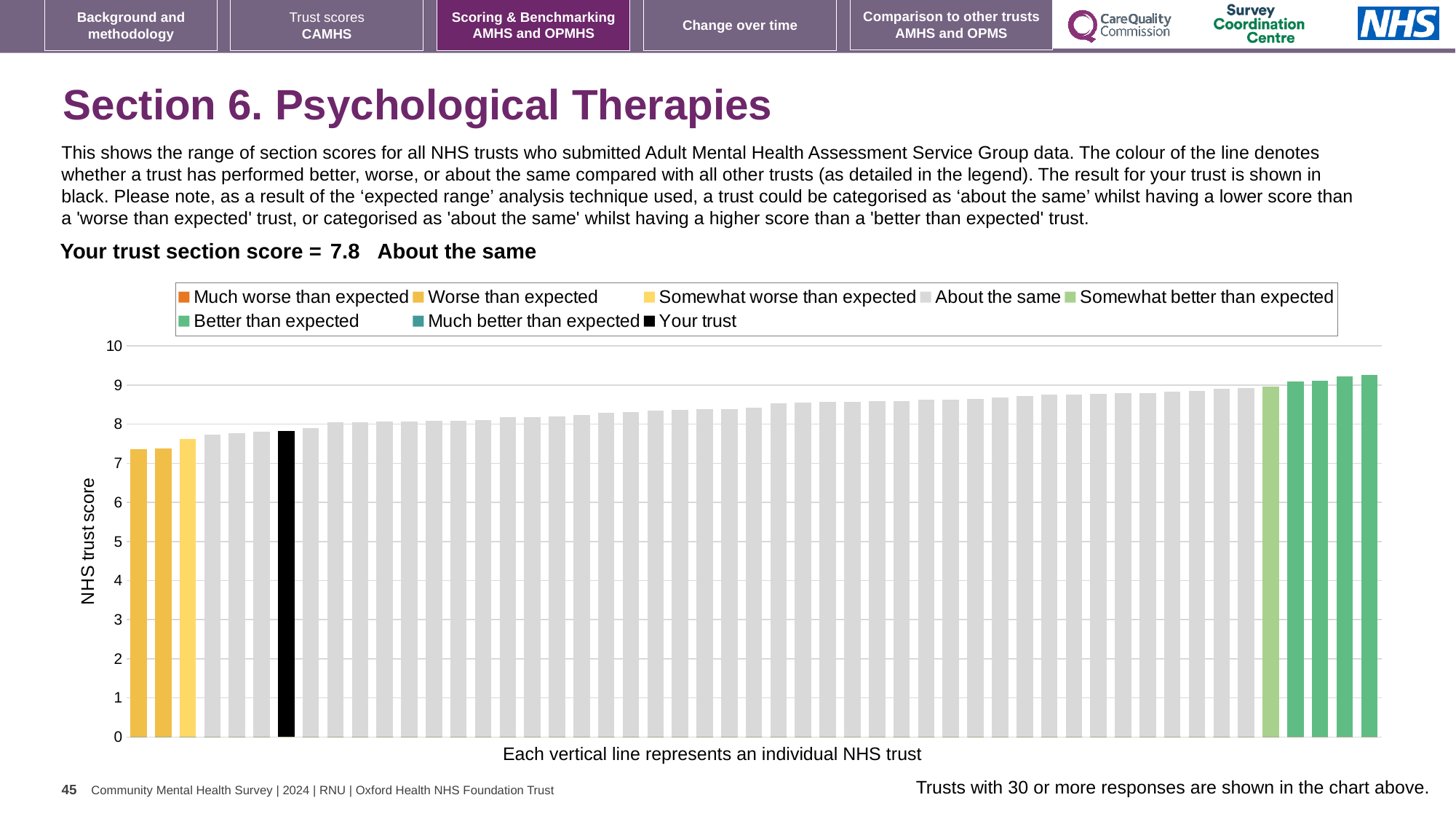
Is the value of the leftmost bar greater or less than 8? less How many entries does the chart legend list? 8 Do the bar values rise or fall from left to right across the chart? rise What is the title of the vertical axis? NHS trust score What type of chart is shown on the slide? bar chart What colour is used for the 'Your trust' bar in the legend? black Which is larger, the leftmost bar or the rightmost bar? the rightmost bar What performance category is given next to your trust's section score? About the same Is the value of the black 'Your trust' bar greater or less than 7? greater What is your trust's section score for Psychological Therapies? 7.8 Is the value of the rightmost bar greater or less than 9? greater How many bars are coloured yellow (Worse than expected)? 2